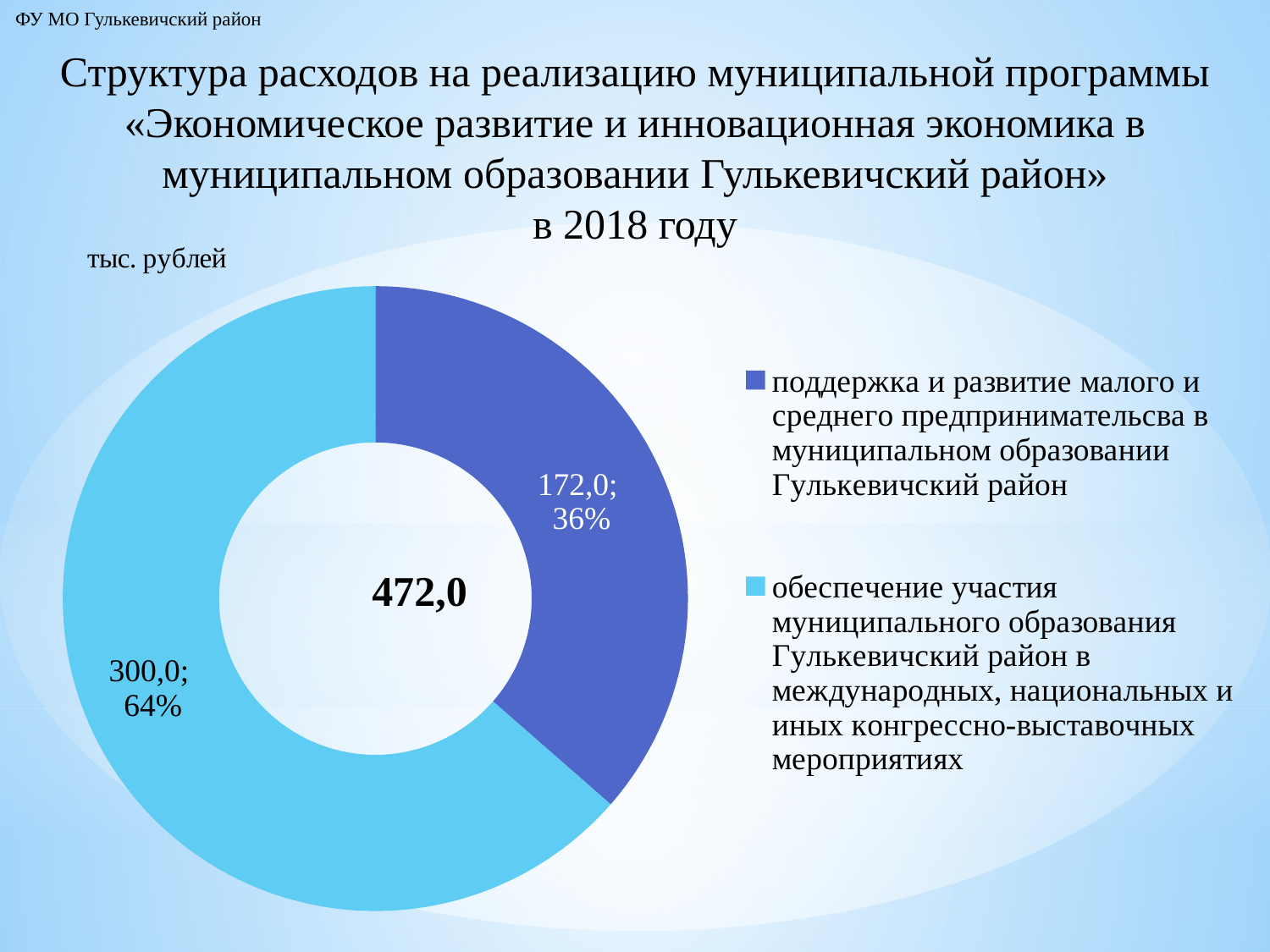
What is the difference between the value for «обеспечение участия ... мероприятиях» (300,0) and «поддержка и развитие малого и среднего предпринимательсва» (172,0)? 128,0 How many categories does the chart show? 2 Which category has the largest value? обеспечение участия муниципального образования Гулькевичский район в международных, национальных и иных конгрессно-выставочных мероприятиях What is the total value shown in the centre of the chart? 472,0 Which is larger: the value for «поддержка и развитие малого и среднего предпринимательсва» or for «обеспечение участия ... в конгрессно-выставочных мероприятиях»? обеспечение участия ... в конгрессно-выставочных мероприятиях What is the value for «обеспечение участия муниципального образования Гулькевичский район в международных, национальных и иных конгрессно-выставочных мероприятиях»? 300,0 In what units are the chart values given? тыс. рублей What is the value for «поддержка и развитие малого и среднего предпринимательсва в муниципальном образовании Гулькевичский район»? 172,0 What share of the total does «обеспечение участия ... в конгрессно-выставочных мероприятиях» account for? 64% What share of the total does «поддержка и развитие малого и среднего предпринимательсва» account for? 36% Which category has the smallest value? поддержка и развитие малого и среднего предпринимательсва в муниципальном образовании Гулькевичский район What kind of chart is shown on the slide? doughnut (pie) chart